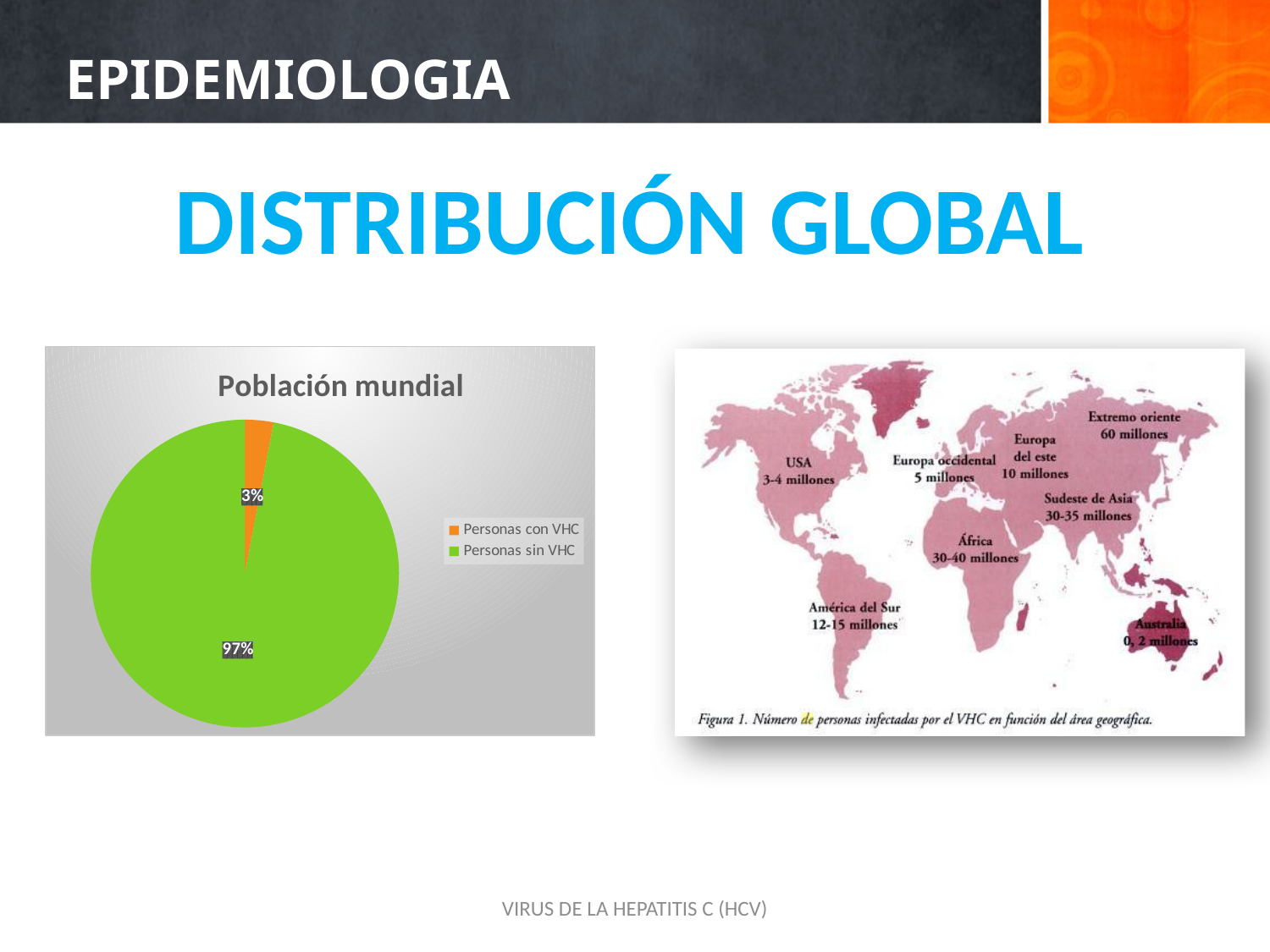
In the "Población mundial" pie chart, which category has the largest slice? Personas sin VHC In the "Población mundial" pie chart, what colour is the Personas con VHC slice? orange How many entries does the legend of the "Población mundial" pie chart list? 2 In the "Población mundial" pie chart, what is the difference in percentage points between Personas sin VHC and Personas con VHC? 94 How many slices does the "Población mundial" pie chart have? 2 In the "Población mundial" pie chart, which is larger: Personas con VHC or Personas sin VHC? Personas sin VHC In the "Población mundial" pie chart, which category has the smallest slice? Personas con VHC In the "Población mundial" pie chart, what share is labelled for Personas con VHC? 3% In the "Población mundial" pie chart, what share is labelled for Personas sin VHC? 97% What kind of chart is the "Población mundial" chart? pie chart In the "Población mundial" pie chart, what is the total of the two labelled shares? 100% What is the title of the pie chart on the left of the slide? Población mundial